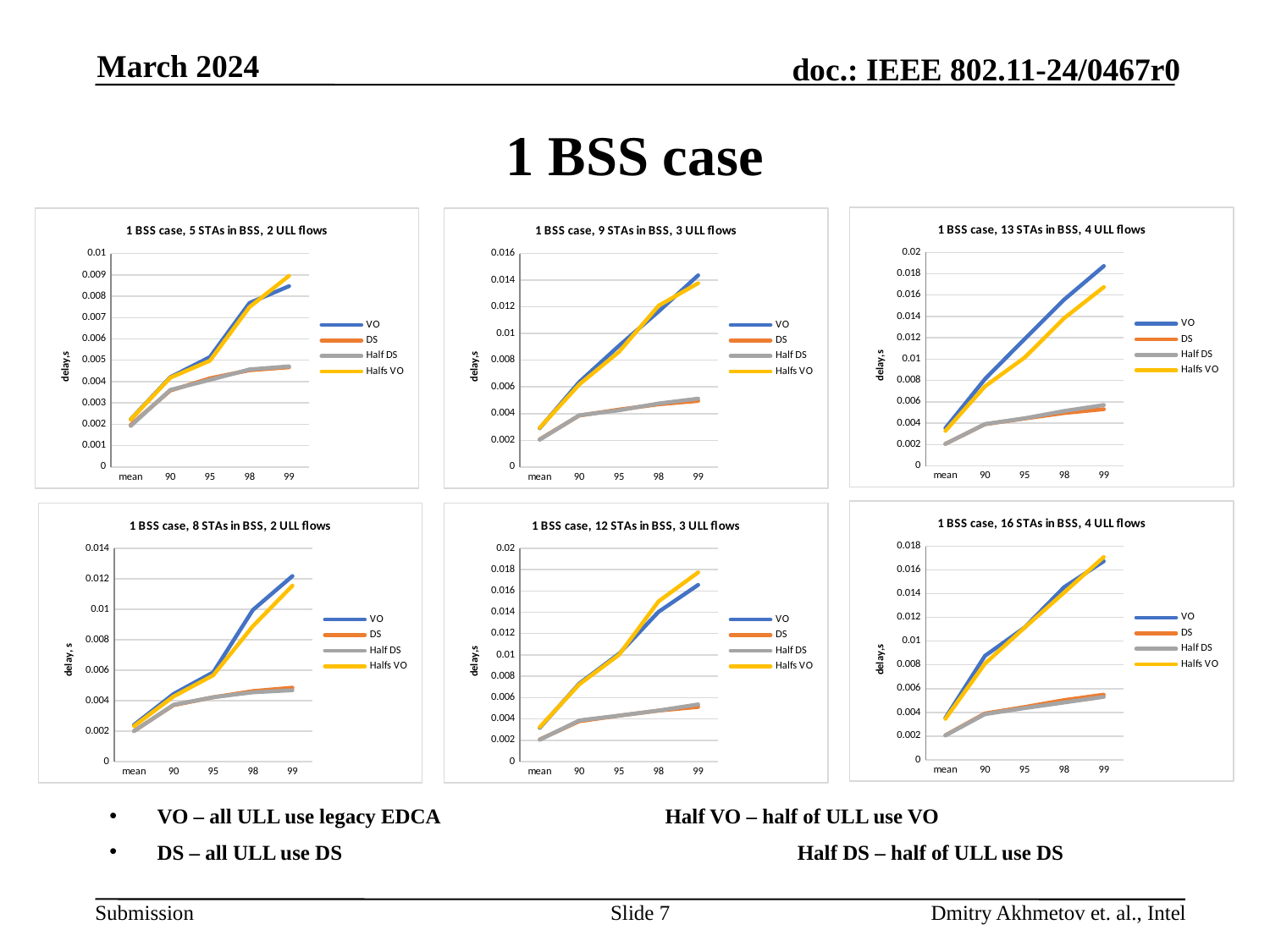
How many points are on the x axis of the chart "1 BSS case, 13 STAs in BSS, 4 ULL flows"? 5 What kind of chart is "1 BSS case, 5 STAs in BSS, 2 ULL flows"? Line chart What is the y-axis label of the chart "1 BSS case, 9 STAs in BSS, 3 ULL flows"? delay,s In the chart "1 BSS case, 12 STAs in BSS, 3 ULL flows", which is larger at 99: VO or Halfs VO? Halfs VO In the chart "1 BSS case, 13 STAs in BSS, 4 ULL flows", is the VO value at 99 greater or less than 0.018? greater In the chart "1 BSS case, 16 STAs in BSS, 4 ULL flows", is the VO value at 99 greater or less than 0.016? greater In the chart "1 BSS case, 5 STAs in BSS, 2 ULL flows", is the Halfs VO value at 99 greater or less than 0.008? greater How many series does the legend list in the chart "1 BSS case, 9 STAs in BSS, 3 ULL flows"? 4 In the chart "1 BSS case, 13 STAs in BSS, 4 ULL flows", which is larger at 99: VO or Halfs VO? VO In the chart "1 BSS case, 13 STAs in BSS, 4 ULL flows", which series has the highest value at 99? VO In the chart "1 BSS case, 8 STAs in BSS, 2 ULL flows", does the VO series rise or fall from mean to 99? Rise